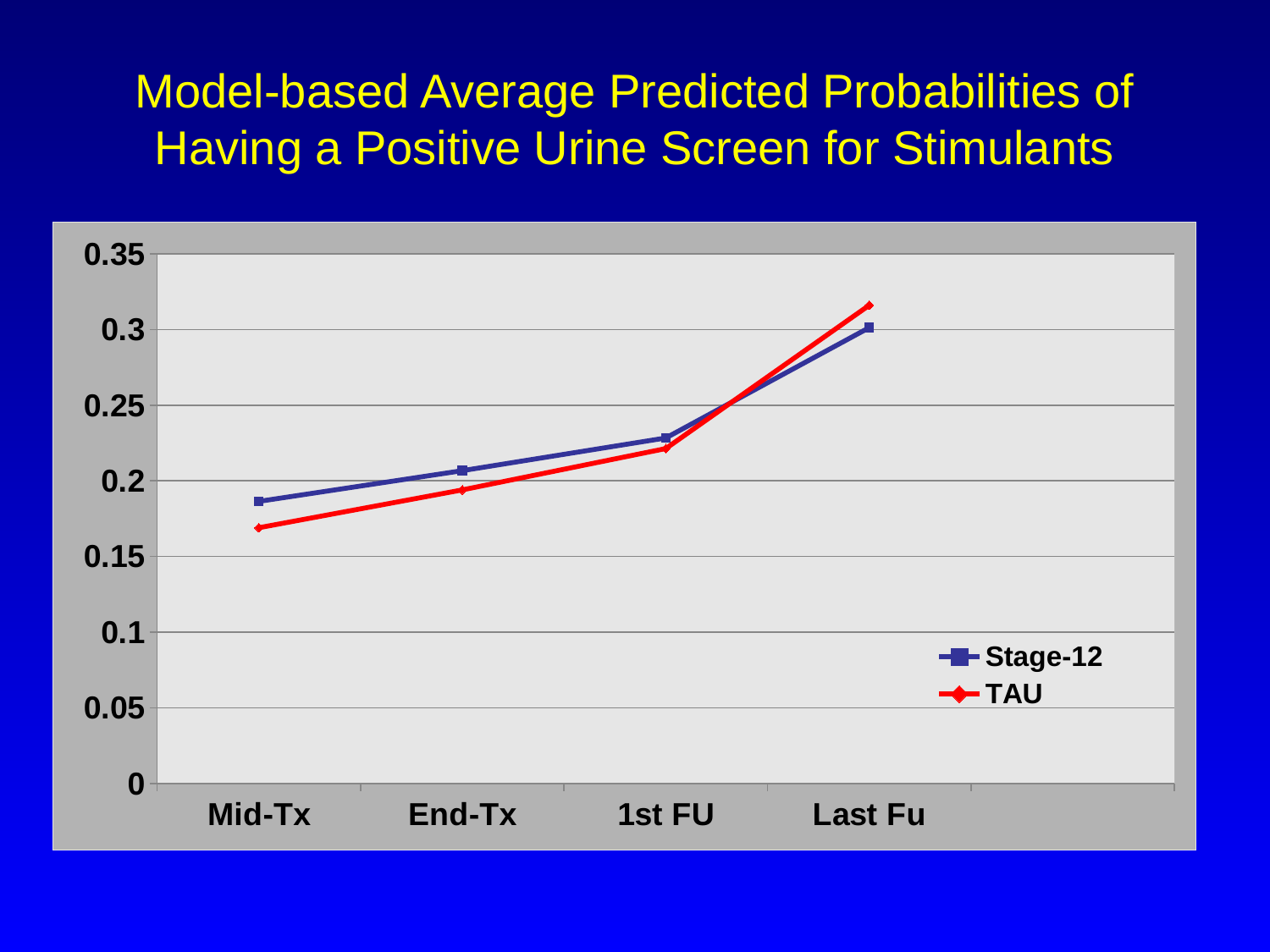
What kind of chart is shown on the slide? line chart Which series is shown in red? TAU Is the value for TAU at Mid-Tx greater or less than 0.2? less Is the value for Stage-12 at 1st FU greater or less than 0.25? less At which time point is the TAU value highest? Last Fu At Mid-Tx, which series has the higher value, Stage-12 or TAU? Stage-12 How many series does the legend list? 2 Do the values for Stage-12 rise or fall from Mid-Tx to Last Fu? rise At which time point is the Stage-12 value lowest? Mid-Tx At Last Fu, which series has the higher value, Stage-12 or TAU? TAU How many time points are shown on the x axis? 4 Is the value for TAU at Last Fu greater or less than 0.3? greater